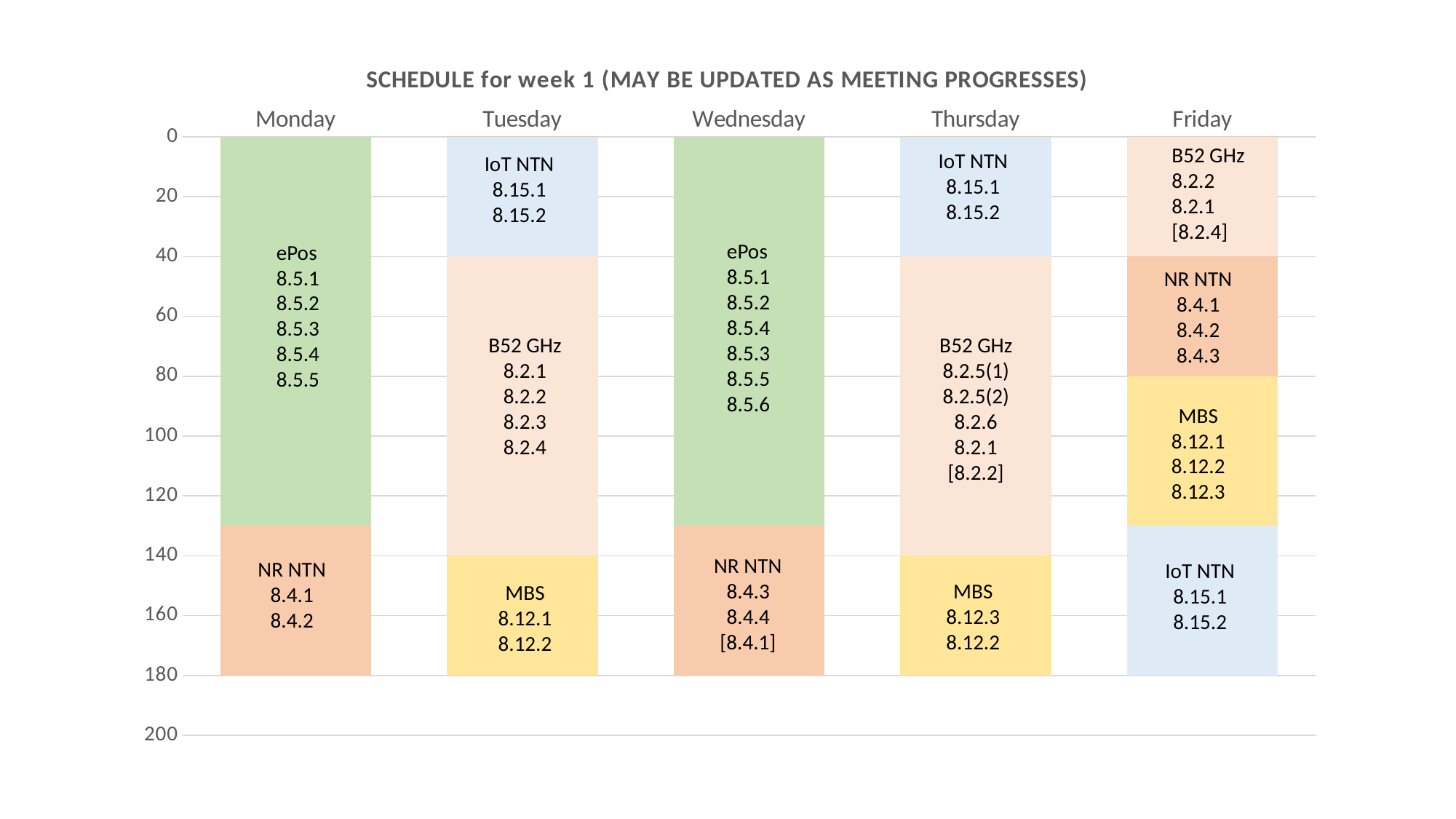
What kind of chart is shown on the slide? bar chart How many axis units does the IoT NTN segment on Tuesday span? 40 Which is larger on Tuesday: the B52 GHz segment or the MBS segment? B52 GHz At what axis value does the bottom of each day's stacked bar end? 180 How many axis units does the NR NTN segment on Friday span? 40 How many days (categories) are shown along the x axis? 5 How many axis units does the B52 GHz segment on Tuesday span? 100 How many axis units does the MBS segment on Thursday span? 40 Is the NR NTN segment on Wednesday greater or less than 60 axis units? less What is the title of the chart? SCHEDULE for week 1 (MAY BE UPDATED AS MEETING PROGRESSES) Is the ePos segment on Monday longer or shorter than 120 axis units? longer How many segments make up the Friday bar? 4